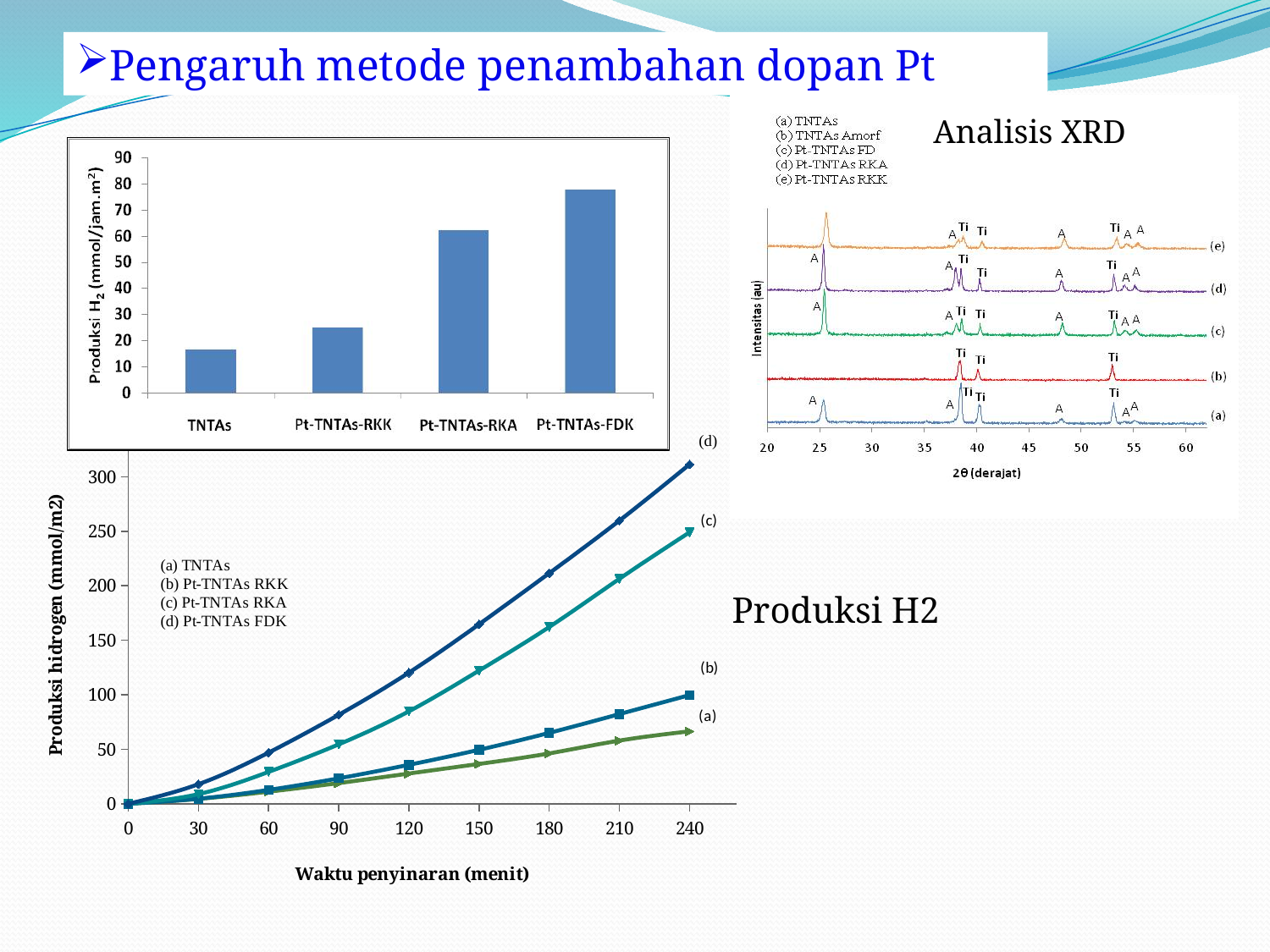
In the top-left bar chart, which category has the highest H2 production? Pt-TNTAs-FDK In the top-left bar chart, which category has the lowest H2 production? TNTAs In the bottom-left 'Produksi hidrogen' line chart, do the values rise or fall as irradiation time increases? rise In the bottom-left 'Produksi hidrogen' line chart, how many series are listed in the legend? 4 In the bottom-left 'Produksi hidrogen' line chart, is the value for series (d) at 240 minutes greater or less than 300? greater In the top-left bar chart, how many categories are shown on the x axis? 4 In the top-right 'Analisis XRD' chart, how many series are listed in the legend? 5 In the top-left bar chart, which is larger, the value for Pt-TNTAs-RKK or the value for Pt-TNTAs-RKA? Pt-TNTAs-RKA In the top-left bar chart, is the value for TNTAs greater or less than 20? less What kind of chart is the top-left chart? bar chart In the top-left bar chart, is the value for Pt-TNTAs-RKA greater or less than 50? greater In the bottom-left 'Produksi hidrogen' line chart, which series has the highest value at 240 minutes? (d) Pt-TNTAs FDK